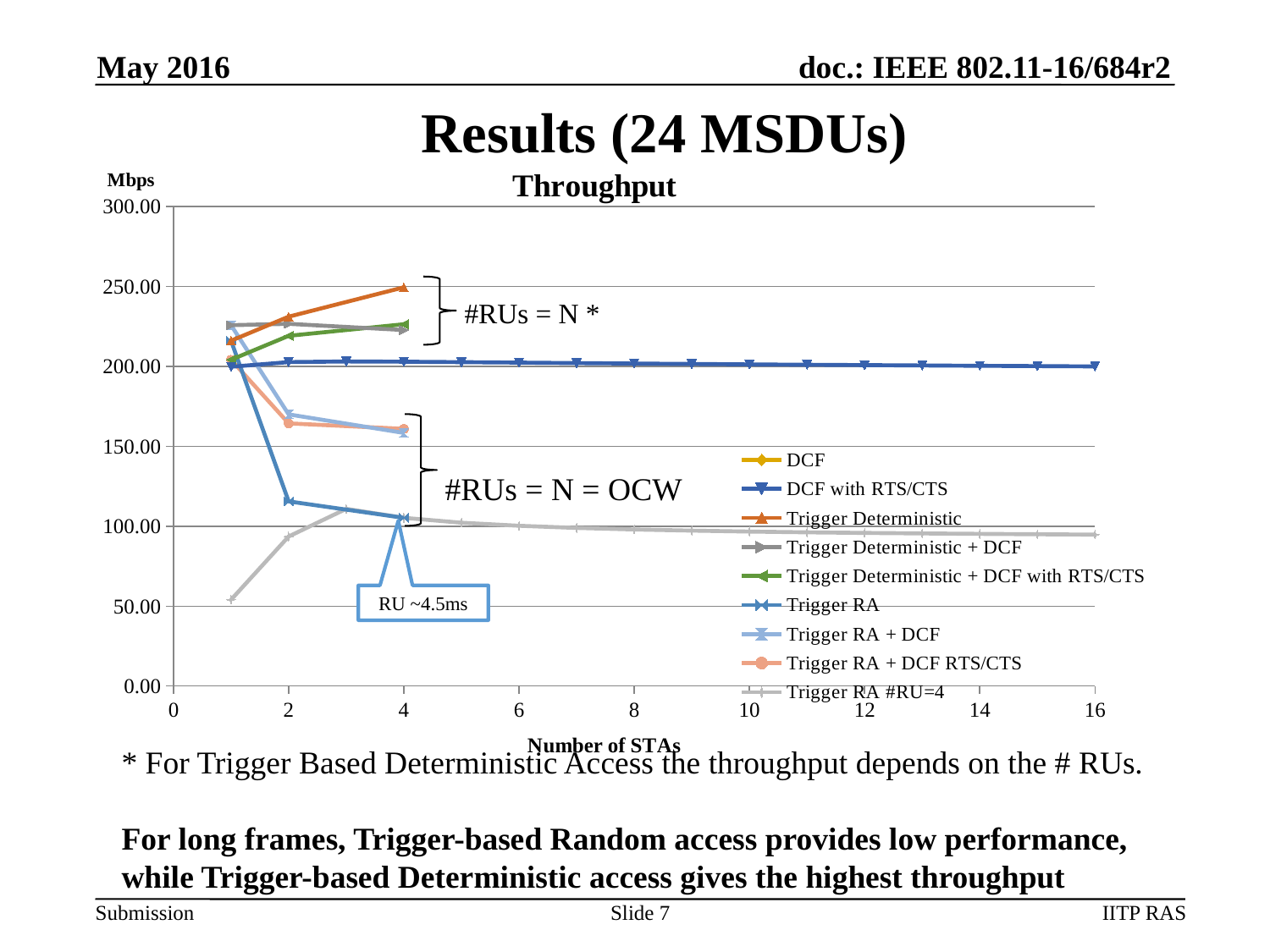
What is the label of the x axis of the chart? Number of STAs Is the value for Trigger RA #RU=4 at 1 STA greater or less than 100? less Which series reaches the highest throughput value on the chart? Trigger Deterministic Does the Trigger Deterministic series rise or fall as the number of STAs increases from 1 to 4? rise Is the value for Trigger Deterministic at 1 STA greater or less than 200? greater What kind of chart is shown on the slide? line chart Is the value for Trigger RA + DCF RTS/CTS at 2 STAs greater or less than 150? greater What is the title of the chart? Throughput Does the Trigger RA series rise or fall as the number of STAs increases from 1 to 4? fall How many series does the legend of the Throughput chart list? 9 At 4 STAs, which is larger: Trigger Deterministic or Trigger RA? Trigger Deterministic